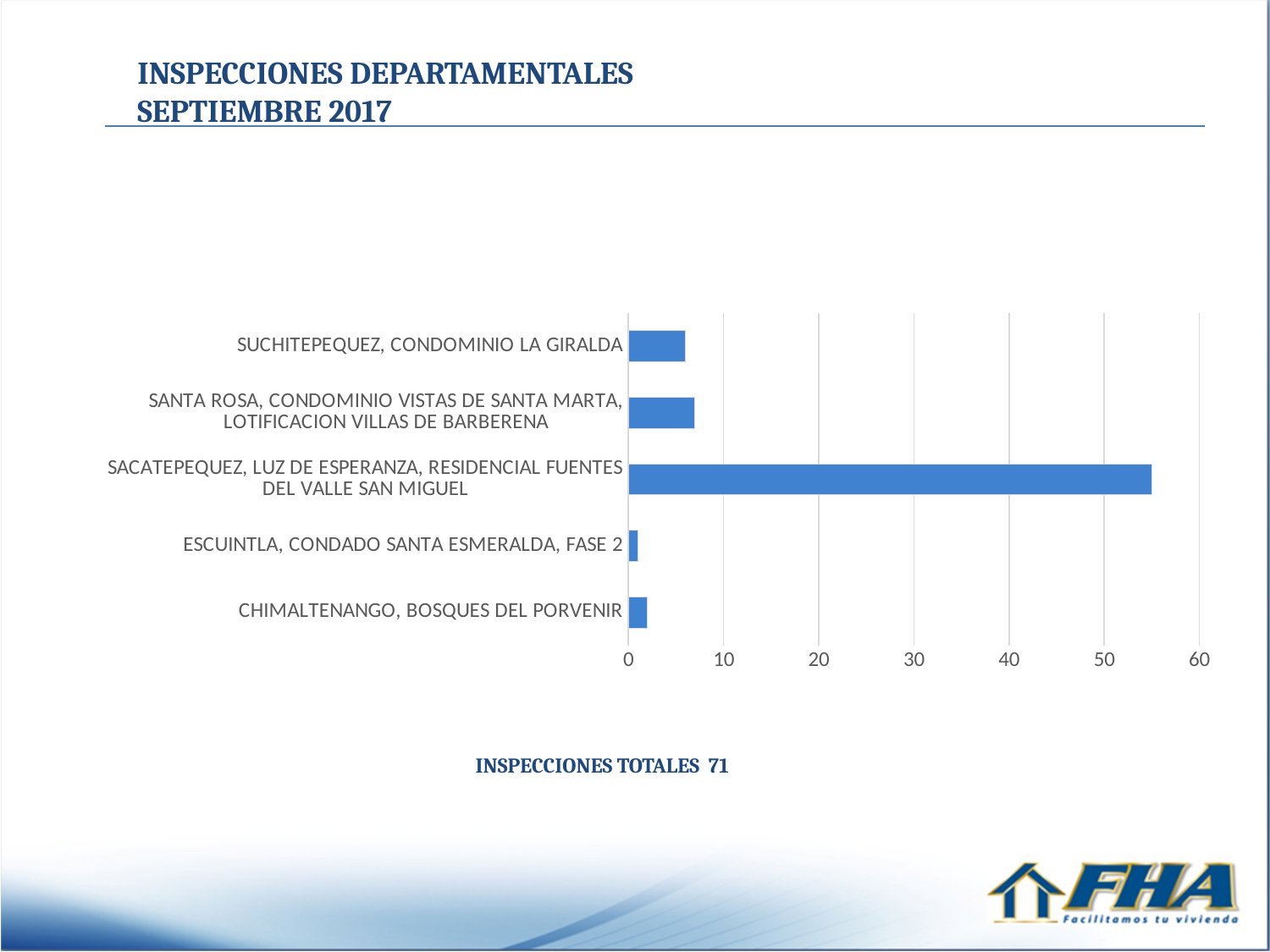
Which category has the highest value in the chart? SACATEPEQUEZ, LUZ DE ESPERANZA, RESIDENCIAL FUENTES DEL VALLE SAN MIGUEL Which is larger: the value for SACATEPEQUEZ, LUZ DE ESPERANZA, RESIDENCIAL FUENTES DEL VALLE SAN MIGUEL or the value for SANTA ROSA, CONDOMINIO VISTAS DE SANTA MARTA, LOTIFICACION VILLAS DE BARBERENA? SACATEPEQUEZ, LUZ DE ESPERANZA, RESIDENCIAL FUENTES DEL VALLE SAN MIGUEL Is the value for SUCHITEPEQUEZ, CONDOMINIO LA GIRALDA greater or less than 10? less Is the value for SACATEPEQUEZ, LUZ DE ESPERANZA, RESIDENCIAL FUENTES DEL VALLE SAN MIGUEL greater or less than 60? less How many categories are plotted in the chart? 5 What kind of chart is shown on the slide? bar chart Which category has the lowest value in the chart? ESCUINTLA, CONDADO SANTA ESMERALDA, FASE 2 Is the value for SACATEPEQUEZ, LUZ DE ESPERANZA, RESIDENCIAL FUENTES DEL VALLE SAN MIGUEL greater or less than 50? greater What is the title shown above the chart? INSPECCIONES DEPARTAMENTALES SEPTIEMBRE 2017 What total number of inspections is stated in the text below the chart? 71